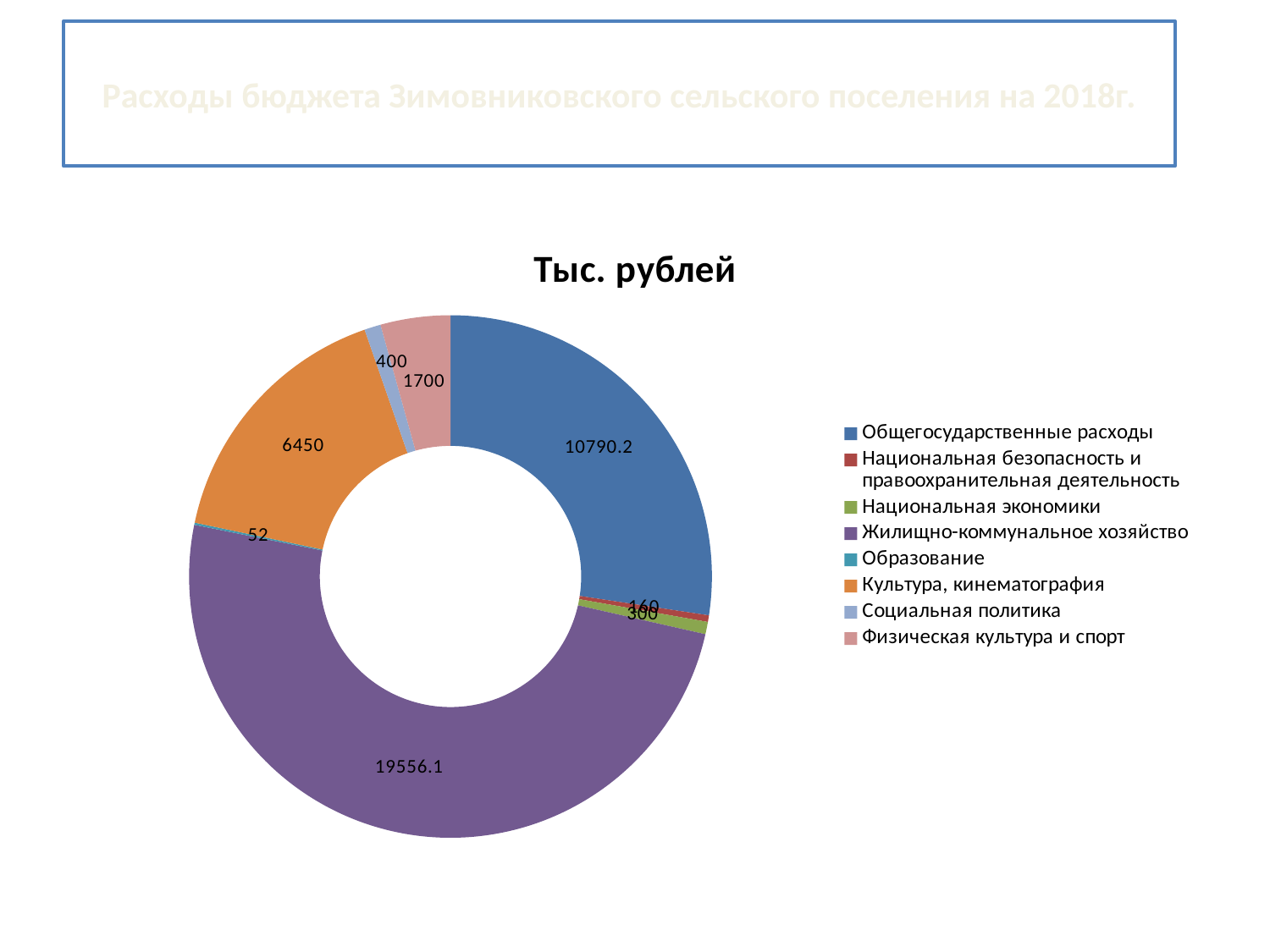
What is the difference between the values for Жилищно-коммунальное хозяйство and Общегосударственные расходы? 8765.9 What kind of chart is shown on the slide? Doughnut (pie) chart What is the value for Образование? 52 What is the chart's title? Тыс. рублей Which category has the smallest value? Образование How many categories does the legend list? 8 What is the value for Жилищно-коммунальное хозяйство? 19556.1 What is the value for Социальная политика? 400 What is the value for Культура, кинематография? 6450 What is the value for Физическая культура и спорт? 1700 Which category has the largest value? Жилищно-коммунальное хозяйство What is the value for Общегосударственные расходы? 10790.2